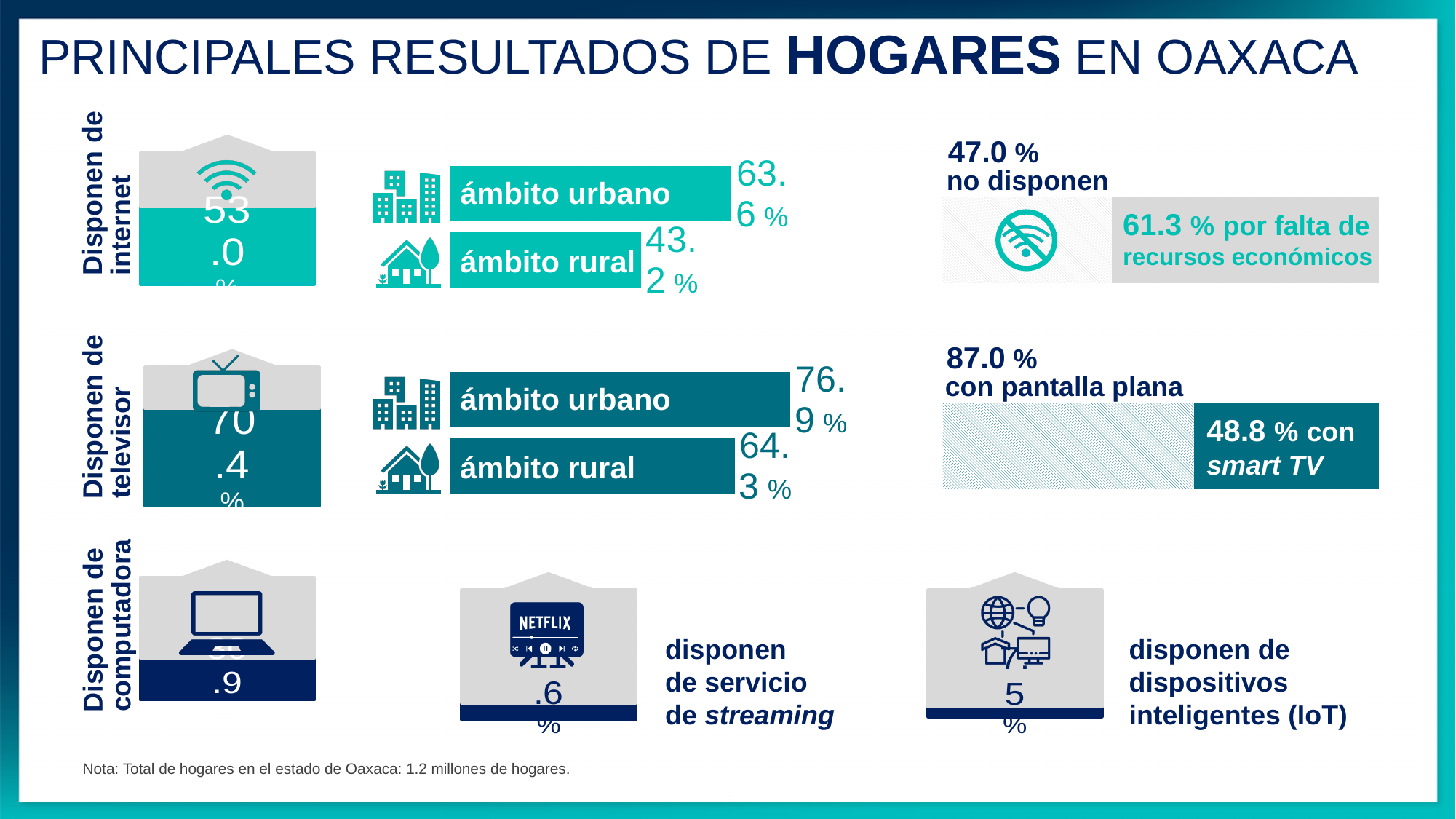
In the 'Disponen de internet' bar chart, what is the value for ámbito urbano? 63.6 % In the 'Disponen de televisor' bar chart, which category has the higher value, ámbito urbano or ámbito rural? ámbito urbano In the 'Disponen de televisor' bar chart, what is the value for ámbito urbano? 76.9 % In the 'Disponen de internet' bar chart, what is the difference between the ámbito urbano and ámbito rural values? 20.4 % In the 'Disponen de televisor' bar chart, what is the value for ámbito rural? 64.3 % What kind of chart is used to compare ámbito urbano and ámbito rural for 'Disponen de televisor'? bar chart In the 'Disponen de televisor' bar chart, what is the difference between the ámbito urbano and ámbito rural values? 12.6 % According to the slide, what percentage of households with a television have a smart TV? 48.8 % How many categories does the 'Disponen de internet' bar chart show? 2 In the 'Disponen de internet' bar chart, what is the value for ámbito rural? 43.2 % What percentage of households in Oaxaca 'Disponen de internet' according to the slide? 53.0 % In the 'Disponen de internet' bar chart, which category has the lowest value? ámbito rural